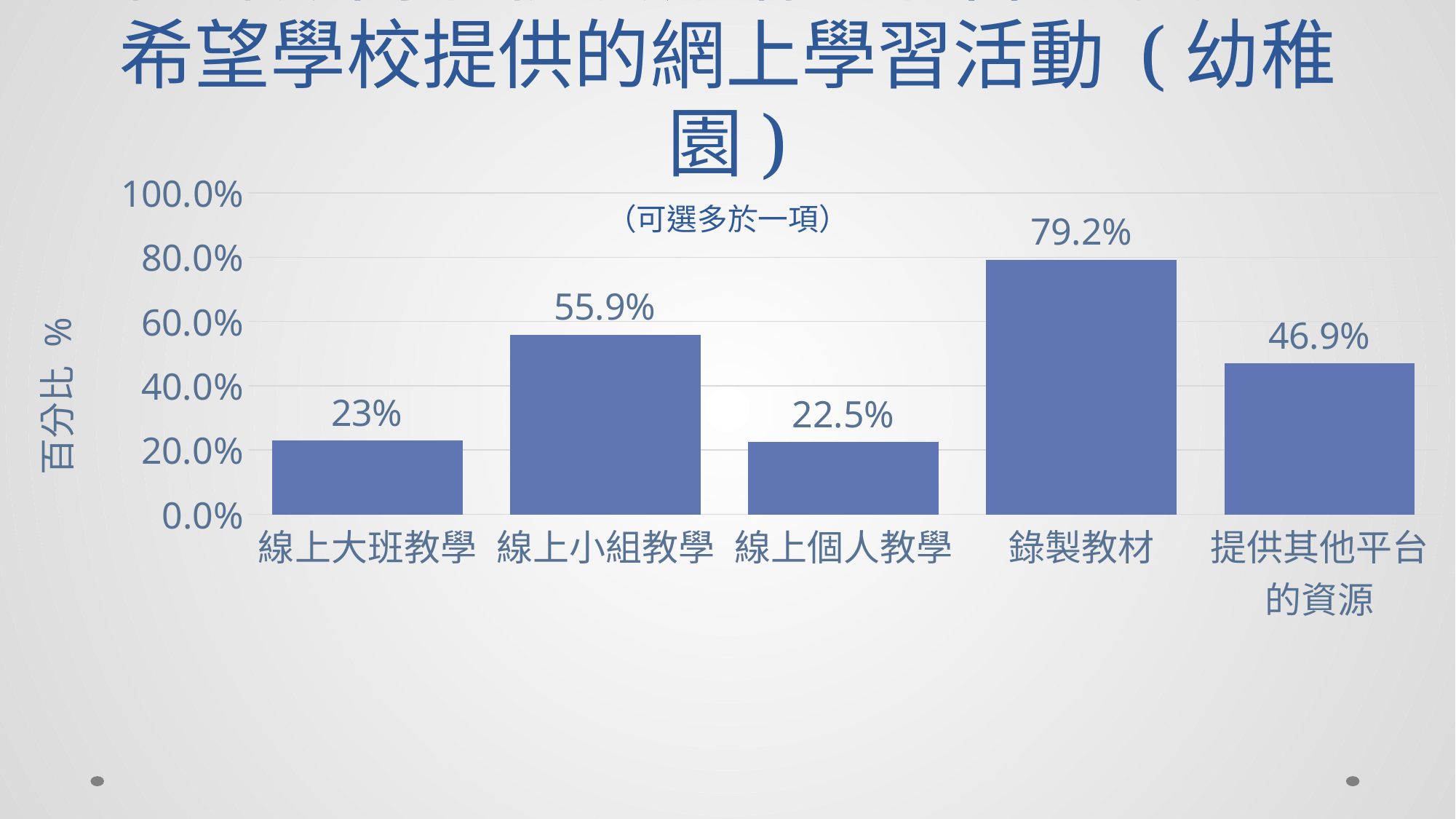
Which category has the lowest value? 線上個人教學 What is the value for 錄製教材? 79.2% Which category has the highest value? 錄製教材 What is the value for 線上大班教學? 23% What is the difference between the values for 錄製教材 and 線上小組教學? 23.3% What is the label on the vertical axis? 百分比 % What is the value for 線上小組教學? 55.9% What is the value for 提供其他平台的資源? 46.9% Which is larger, the value for 線上小組教學 or the value for 提供其他平台的資源? 線上小組教學 What kind of chart is shown on the slide? bar chart How many categories are shown in the chart? 5 Is the value for 線上個人教學 greater or less than 40.0%? less